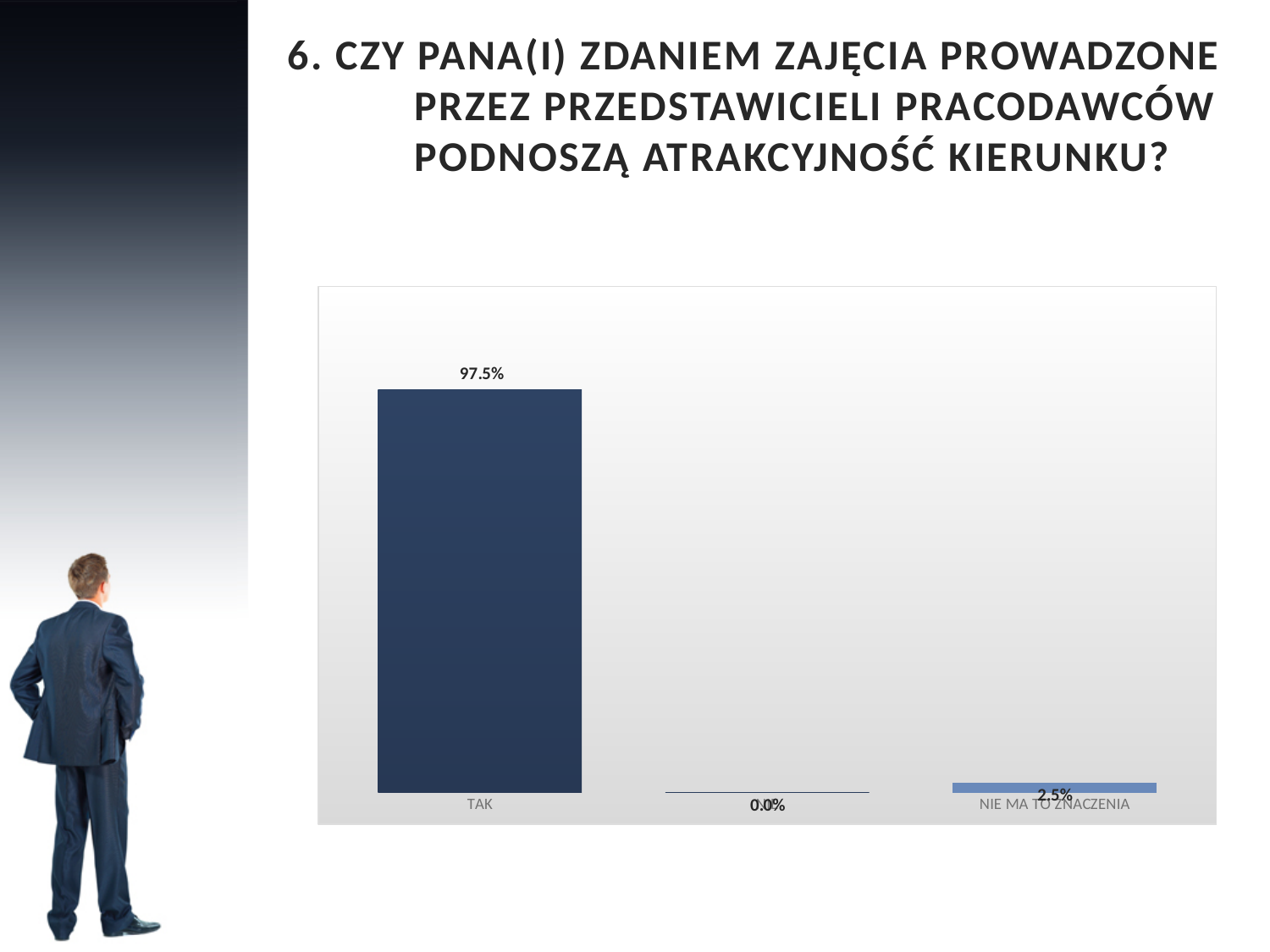
What do the three percentages on the chart add up to? 100.0% What is the value for NIE MA TO ZNACZENIA? 2.5% What is the value for TAK? 97.5% What colour is the bar for TAK? dark blue What is the difference between the values for TAK and NIE MA TO ZNACZENIA? 95.0% What is the lowest data label shown on the chart? 0.0% Does the chart display a legend? No Which category has the highest value? TAK What kind of chart is shown on the slide? bar chart How many bars (categories) are shown on the chart? 3 Which is larger, the value for TAK or the value for NIE MA TO ZNACZENIA? TAK